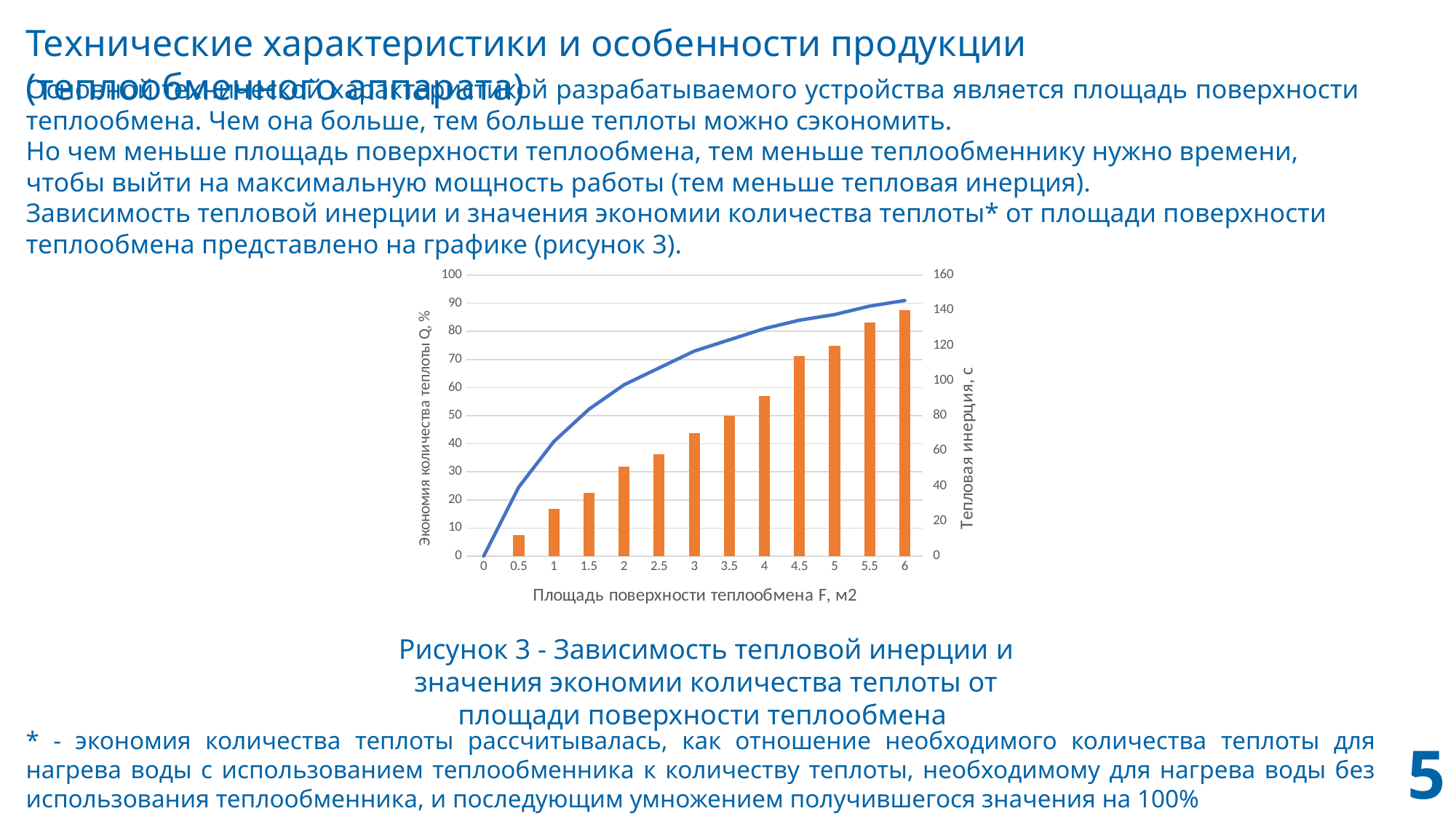
How many values are marked on the x axis (Площадь поверхности теплообмена F, м2)? 13 Which orange bar is taller: the one for F = 5 or the one for F = 3? F = 5 At which surface area F is the shortest non-zero orange bar (Тепловая инерция)? 0.5 Is the orange bar for F = 1 greater or less than 40 on the right axis (Тепловая инерция, с)? less Is the orange bar for F = 5.5 greater or less than 120 on the right axis (Тепловая инерция, с)? greater At which surface area F is the orange bar (Тепловая инерция) the tallest? 6 Is the blue line value for F = 3 greater or less than 60 on the left axis (Экономия количества теплоты Q, %)? greater What is the title of the right vertical axis of the chart? Тепловая инерция, с Do the orange bars (Тепловая инерция) rise or fall as the surface area F increases? Rise What kind of chart is shown on the slide? A combined bar and line chart Does the blue line (Экономия количества теплоты Q, %) rise or fall as the surface area F increases? Rise